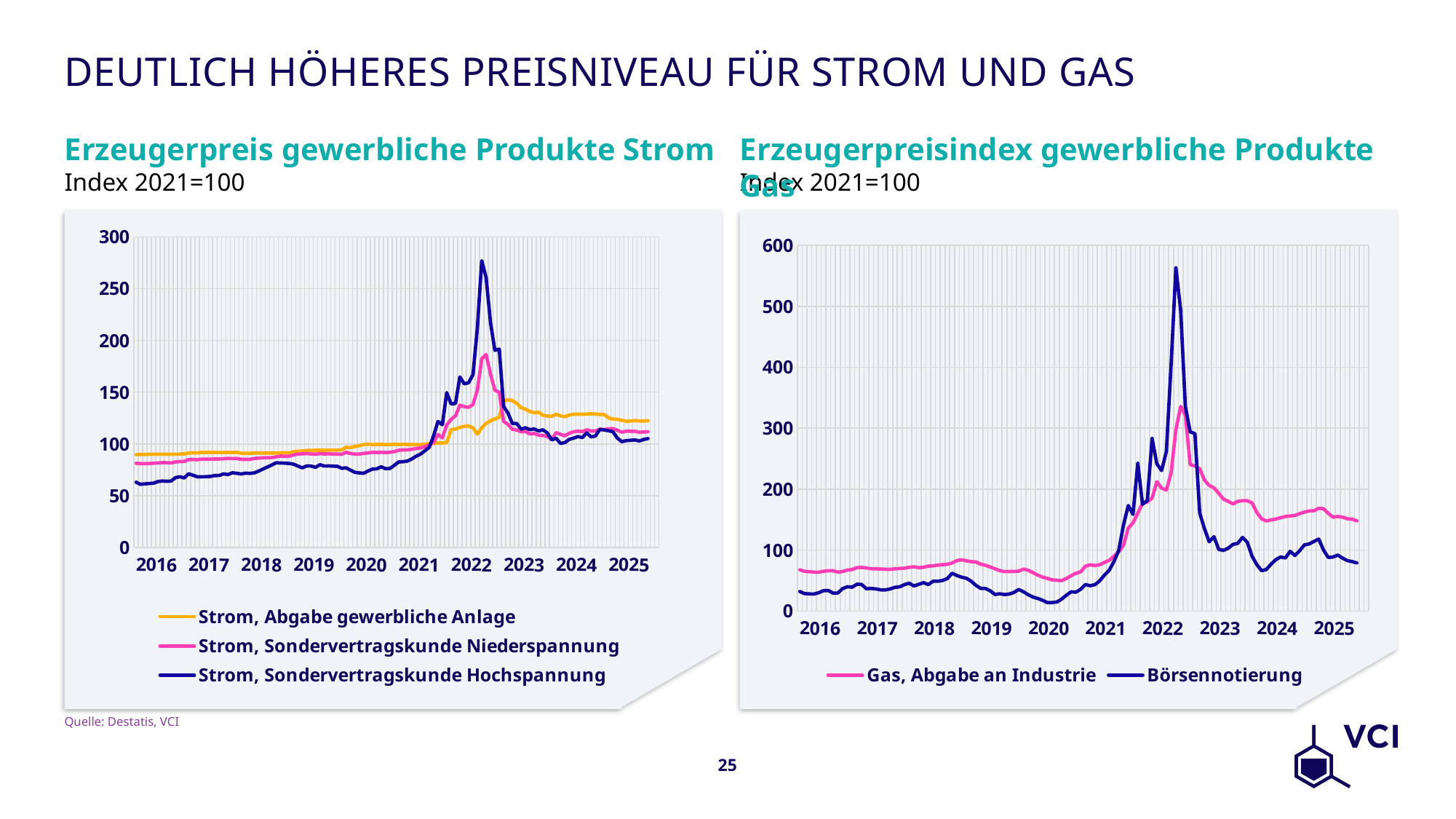
In the left chart, 'Erzeugerpreis gewerbliche Produkte Strom', which series reaches the highest peak in 2022? Strom, Sondervertragskunde Hochspannung In the right chart, 'Erzeugerpreisindex gewerbliche Produkte Gas', does 'Börsennotierung' rise or fall from its 2022 peak to 2025? fall In the right chart, 'Erzeugerpreisindex gewerbliche Produkte Gas', which series reaches the highest peak in 2022? Börsennotierung In the right chart, 'Erzeugerpreisindex gewerbliche Produkte Gas', is the value of 'Börsennotierung' in 2020 greater or less than 100? less In the right chart, 'Erzeugerpreisindex gewerbliche Produkte Gas', is the 2022 peak of 'Börsennotierung' greater or less than 500? greater How many year labels are shown on the x axis of the right chart, 'Erzeugerpreisindex gewerbliche Produkte Gas'? 10 What base year is the index in both charts set to 100? 2021 How many series does the legend of the left chart, 'Erzeugerpreis gewerbliche Produkte Strom', list? 3 How many series does the legend of the right chart, 'Erzeugerpreisindex gewerbliche Produkte Gas', list? 2 In the left chart, 'Erzeugerpreis gewerbliche Produkte Strom', is the 2022 peak of 'Strom, Sondervertragskunde Niederspannung' greater or less than 200? less What kind of chart is the left chart, 'Erzeugerpreis gewerbliche Produkte Strom'? Line chart